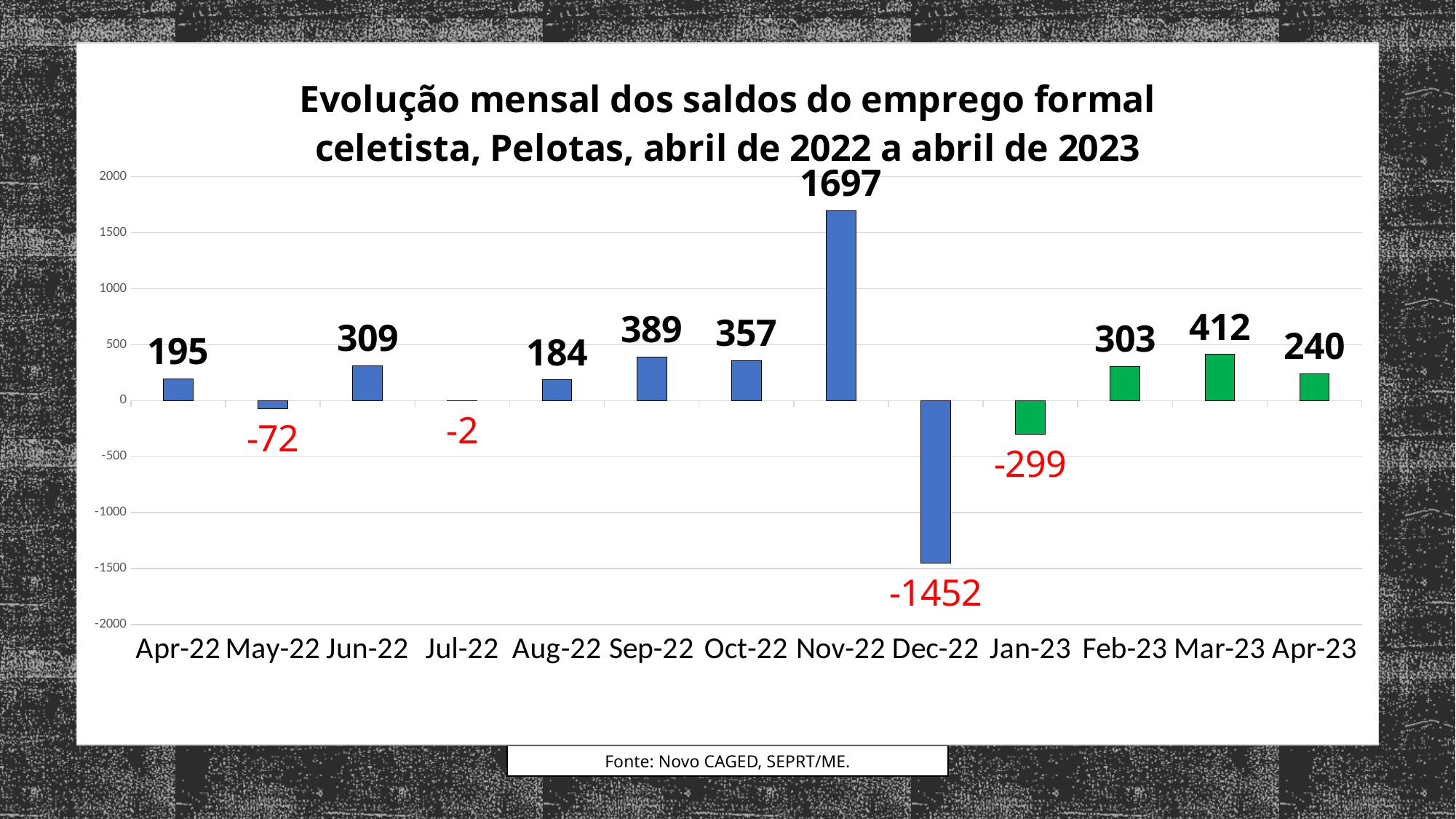
What is the value for Jan-23? -299 What is the difference between the values for Mar-23 and Feb-23? 109 Which month has the highest value? Nov-22 How many months are shown on the x axis? 13 What is the value for Dec-22? -1452 What is the value for Nov-22? 1697 Which is larger, the value for Sep-22 or the value for Oct-22? Sep-22 Is the value for Nov-22 greater or less than 1500? greater What kind of chart is shown on the slide? bar chart Which month has the lowest value? Dec-22 What is the value for Jul-22? -2 What source is cited below the chart? Novo CAGED, SEPRT/ME.